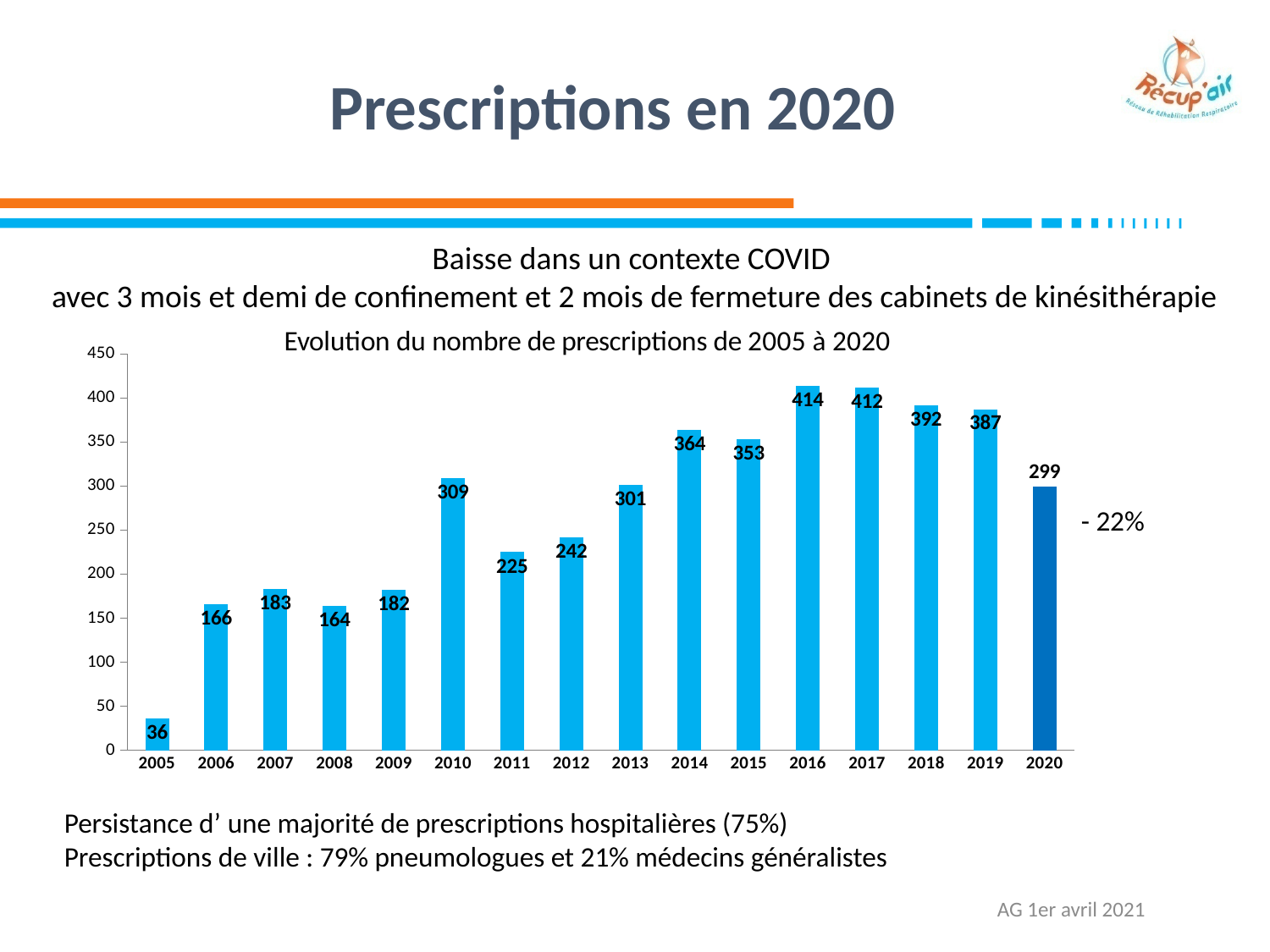
What is the difference between the number of prescriptions in 2019 and in 2020? 88 Do the values rise or fall from 2016 to 2020? fall How many years are shown on the x axis? 16 Which year has more prescriptions, 2013 or 2014? 2014 Is the value for 2012 greater or less than 250? less Which year has the lowest number of prescriptions? 2005 What kind of chart is shown on the slide? bar chart What percentage change is annotated next to the 2020 bar? - 22% What is the number of prescriptions in 2010? 309 Which year has the highest number of prescriptions? 2016 What is the title of the chart? Evolution du nombre de prescriptions de 2005 à 2020 What is the number of prescriptions in 2020? 299